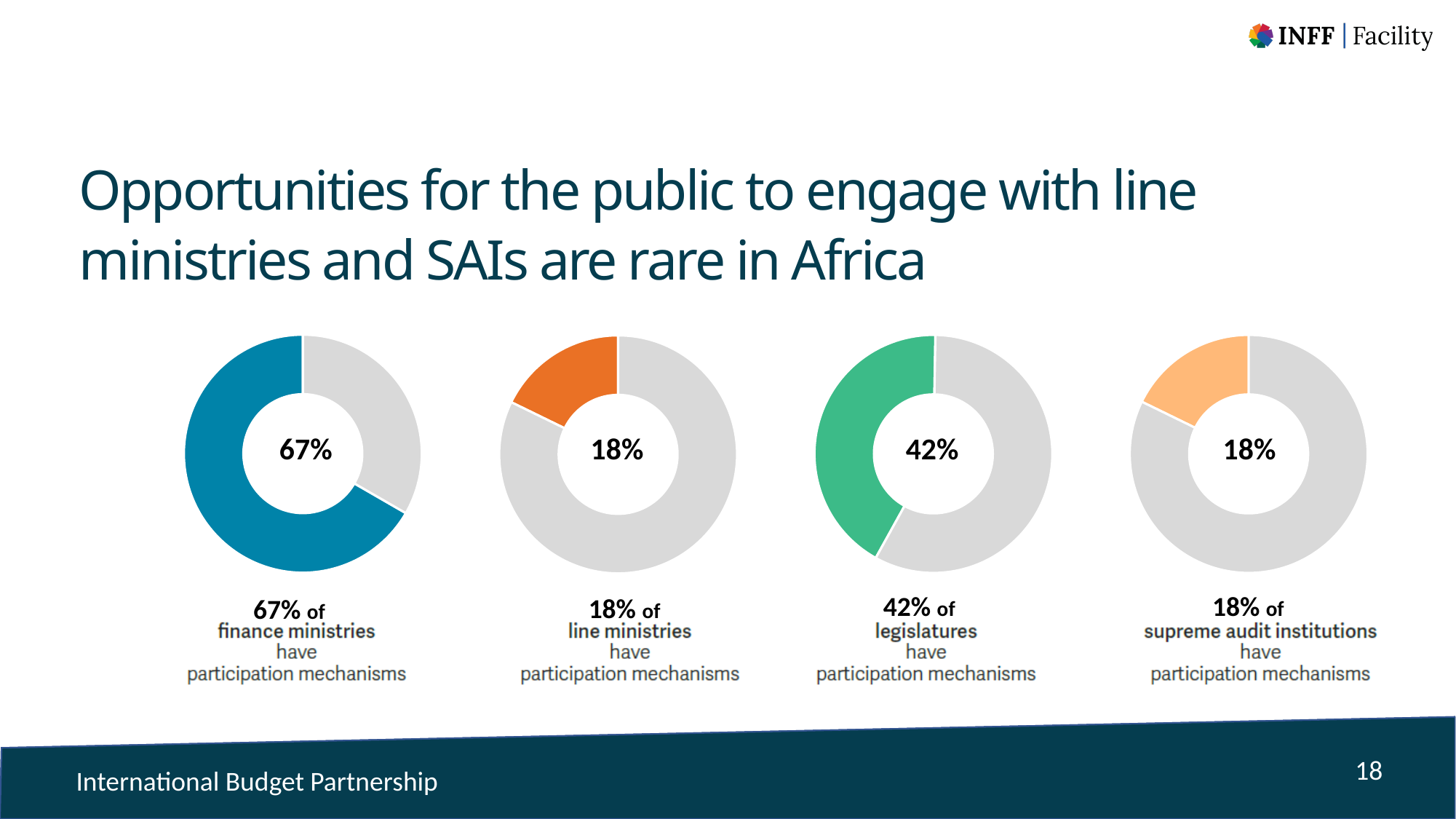
What is the difference in percentage points between the legislatures chart and the line ministries chart? 24 percentage points What percentage of line ministries have participation mechanisms, according to the second donut chart? 18% What kind of chart is used to show each percentage on the slide? donut (pie) chart Across the four donut charts, which institution type has the highest share with participation mechanisms? finance ministries Which is larger: the share for legislatures or the share for supreme audit institutions? legislatures Across the four donut charts, which institution type has the lowest share with participation mechanisms? line ministries and supreme audit institutions (both 18%) What percentage of legislatures have participation mechanisms, according to the third donut chart? 42% What percentage of supreme audit institutions have participation mechanisms, according to the fourth donut chart? 18% What colour is the highlighted segment in the legislatures donut chart? green What is the difference in percentage points between the finance ministries chart and the legislatures chart? 25 percentage points How many donut charts are shown on the slide? 4 What percentage of finance ministries have participation mechanisms, according to the first donut chart? 67%